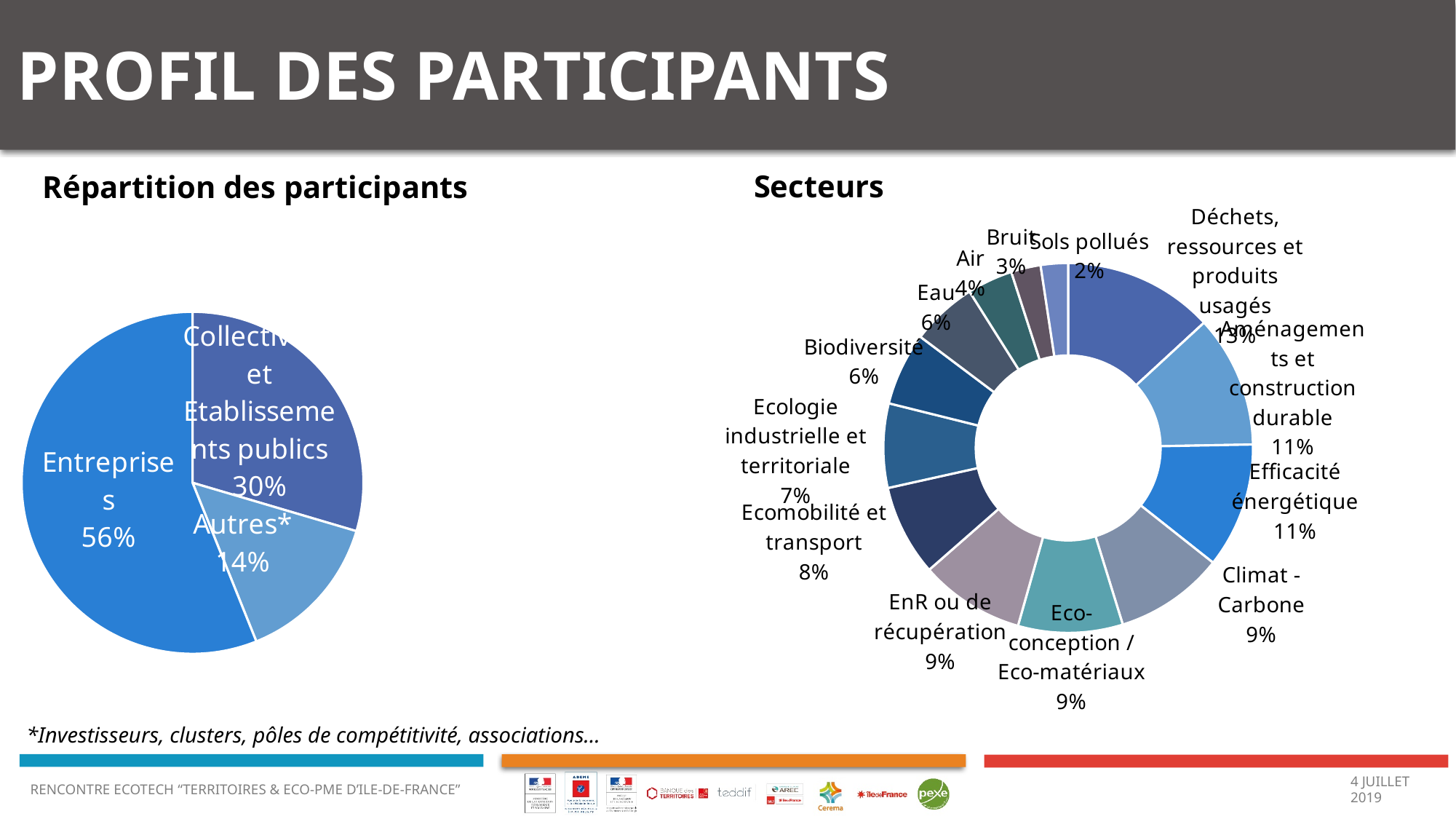
In the 'Secteurs' chart, which sector has the largest share? Déchets, ressources et produits usagés In the 'Secteurs' chart, what share is shown for Ecomobilité et transport? 8% What type of chart is 'Répartition des participants'? Pie chart In the 'Secteurs' chart, which is larger: Biodiversité or Air? Biodiversité In the 'Répartition des participants' chart, what share do Entreprises represent? 56% In the 'Répartition des participants' chart, which category has the largest share? Entreprises In the 'Secteurs' chart, what share is shown for Efficacité énergétique? 11% How many slices does the 'Répartition des participants' chart have? 3 How many sectors are shown in the 'Secteurs' chart? 13 In the 'Répartition des participants' chart, what share is labelled Autres*? 14% In the 'Répartition des participants' chart, what is the difference between the Entreprises share and the Collectivités et Etablissements publics share? 26 percentage points In the 'Secteurs' chart, which sector has the smallest share? Sols pollués